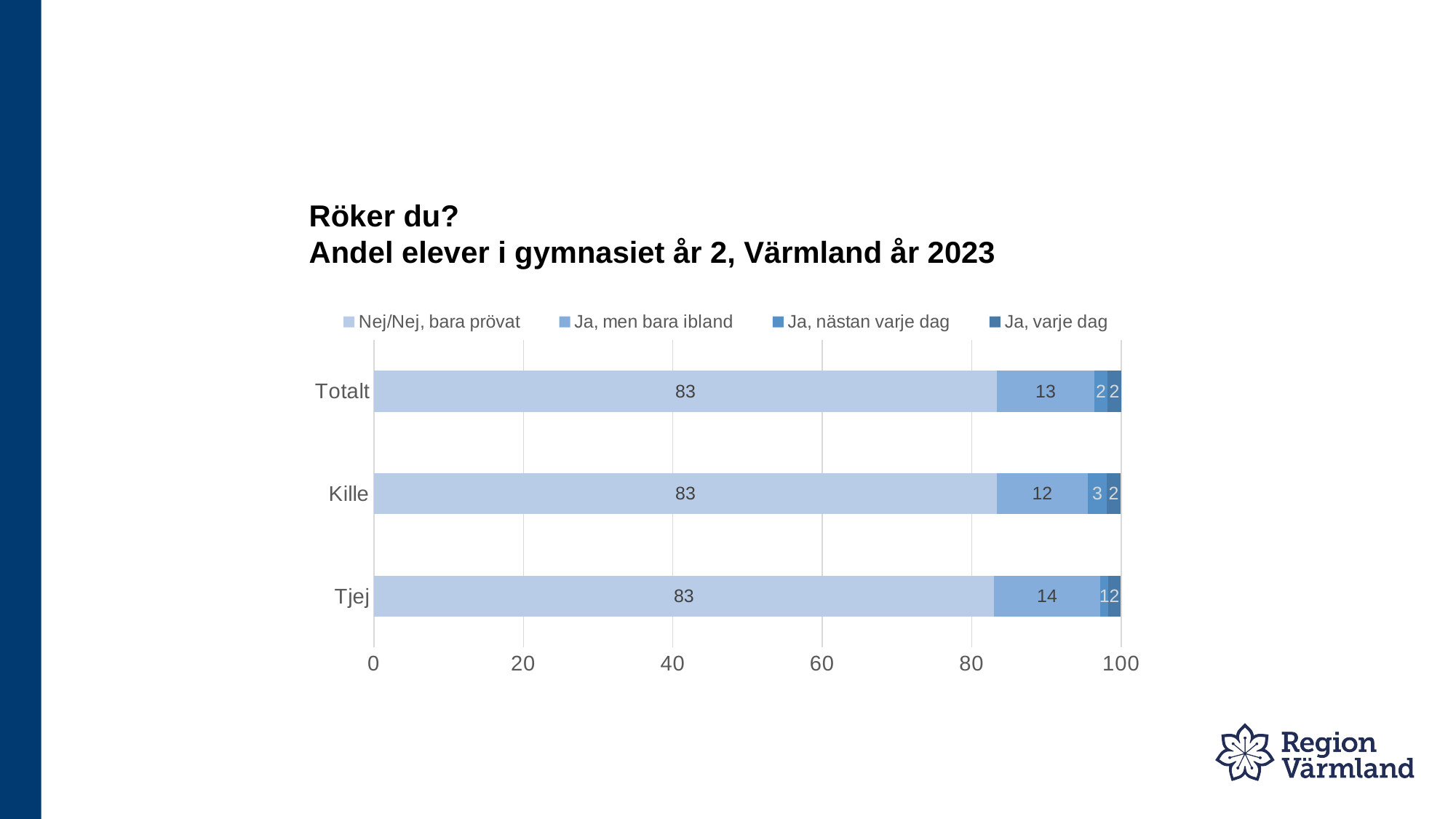
What is the difference between the 'Ja, men bara ibland' values for Tjej and Kille? 2 How many series does the legend list? 4 What is the value for 'Ja, nästan varje dag' for Kille? 3 What is the total of the stacked bar for Kille? 100 What is the value for 'Nej/Nej, bara prövat' for Totalt? 83 What type of chart is shown on the slide? Stacked bar chart Which is larger: 'Ja, nästan varje dag' for Kille or for Totalt? Kille What is the value for 'Ja, men bara ibland' for Tjej? 14 How many categories are shown on the vertical axis? 3 Which category has the highest value for 'Ja, men bara ibland'? Tjej Which category has the lowest value for 'Ja, nästan varje dag'? Tjej What is the value for 'Ja, varje dag' for Totalt? 2